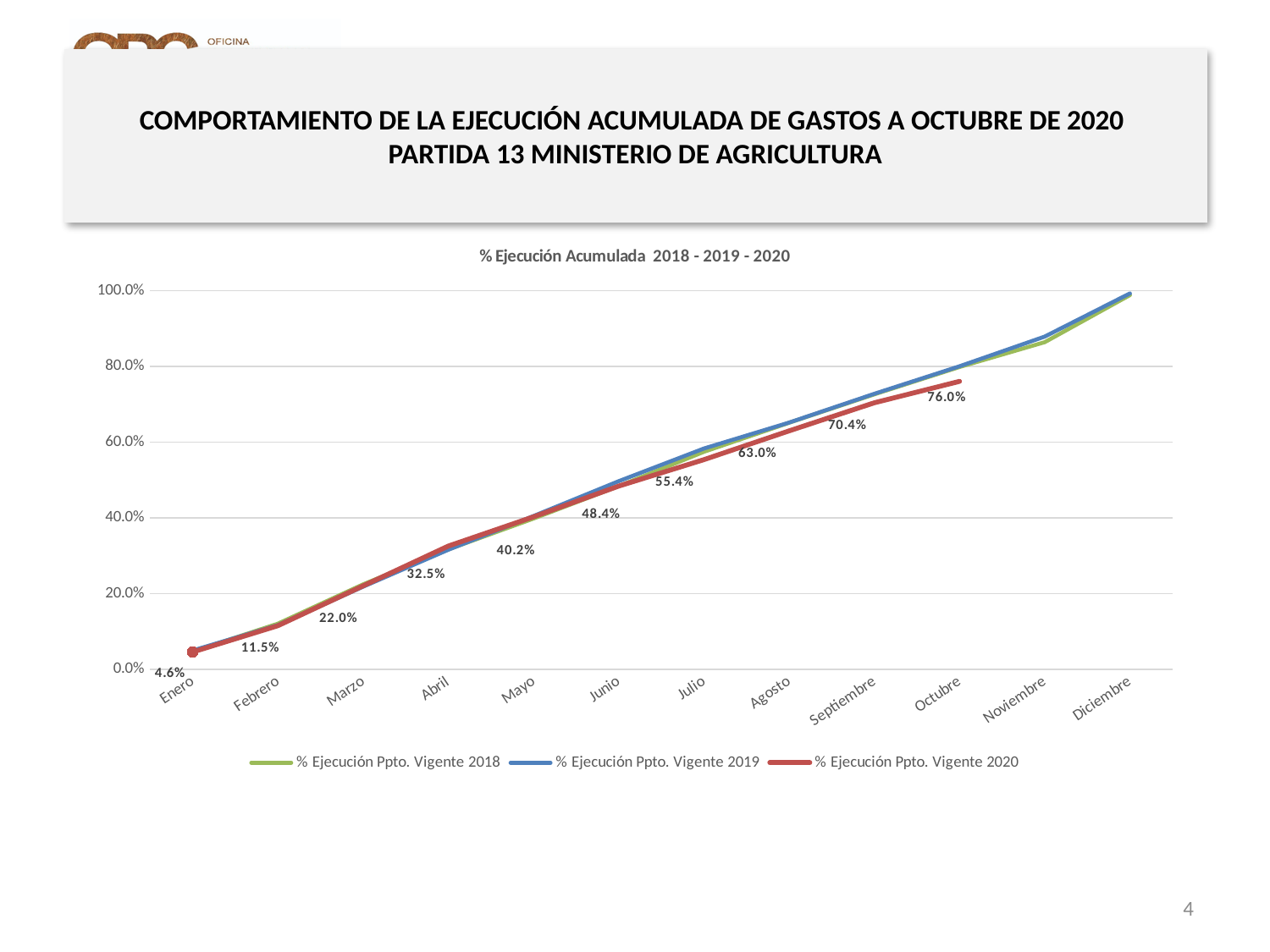
What is the chart's title? % Ejecución Acumulada 2018 - 2019 - 2020 What is the value for % Ejecución Ppto. Vigente 2020 in Junio? 48.4% What is the difference between the 2020 values for Agosto and Julio? 7.6% What is the difference between the 2020 values for Octubre and Septiembre? 5.6% Does the % Ejecución Ppto. Vigente 2020 series rise or fall from Enero to Octubre? rise What is the value for % Ejecución Ppto. Vigente 2020 in Enero? 4.6% How many months are shown on the x axis? 12 How many series does the legend list? 3 What is the value for % Ejecución Ppto. Vigente 2020 in Octubre? 76.0% Is the value for % Ejecución Ppto. Vigente 2019 in Diciembre greater or less than 80.0%? greater Which colour is used for the % Ejecución Ppto. Vigente 2020 series? red What type of chart is shown on the slide? line chart